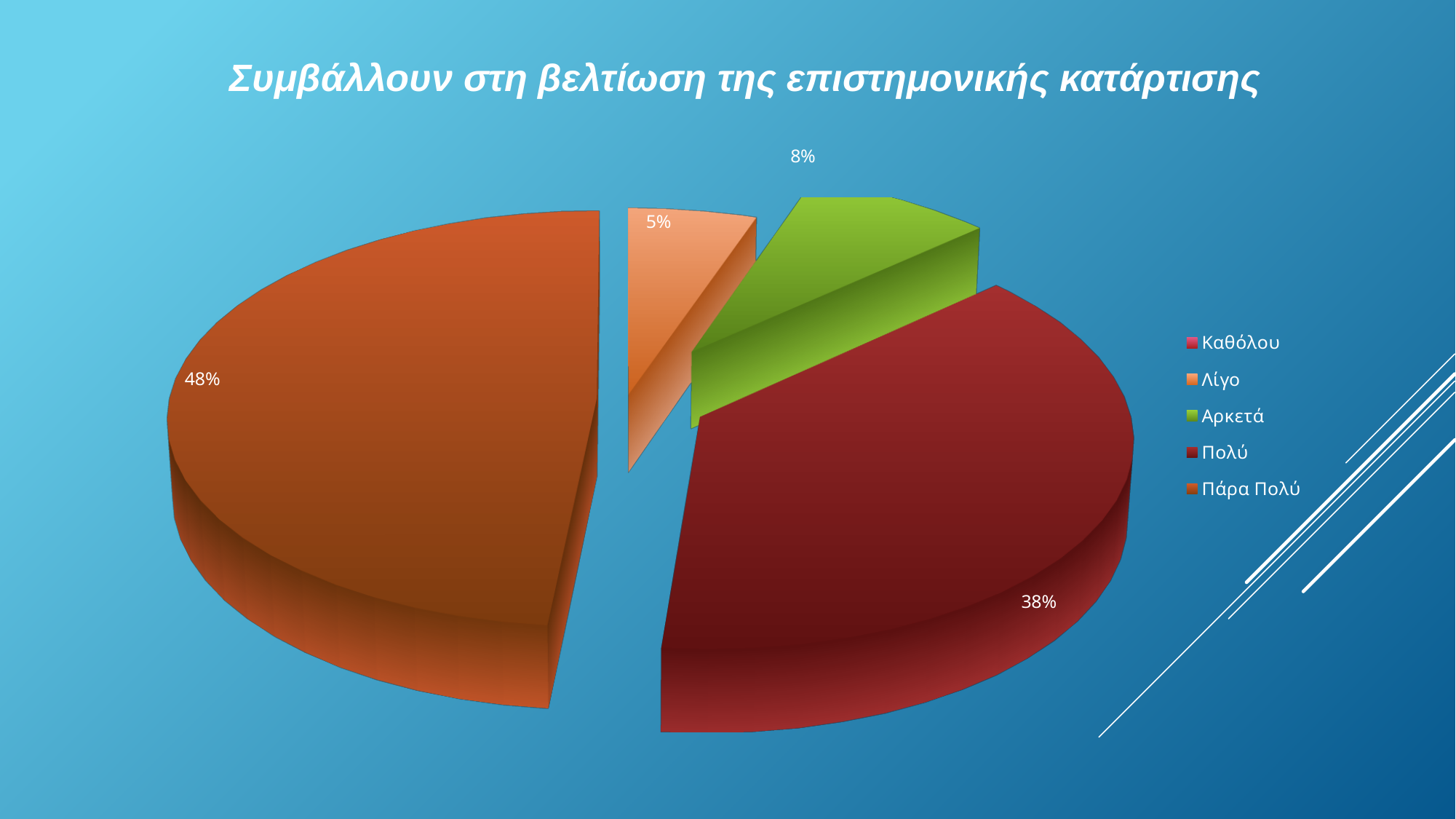
What is the title of the chart? Συμβάλλουν στη βελτίωση της επιστημονικής κατάρτισης What is the difference in percentage points between the Πάρα Πολύ and Πολύ slices? 10 How many categories does the legend list? 5 Which of the labelled slices is the smallest? Λίγο Which category has the largest slice of the pie? Πάρα Πολύ What share of the pie does the Πολύ slice represent? 38% What percentage is shown for the Λίγο slice? 5% Which slice is larger, Αρκετά or Λίγο? Αρκετά What percentage is shown for the Πολύ slice? 38% What percentage is shown for the Πάρα Πολύ slice? 48% What kind of chart is shown on the slide? pie chart What percentage is shown for the Αρκετά slice? 8%